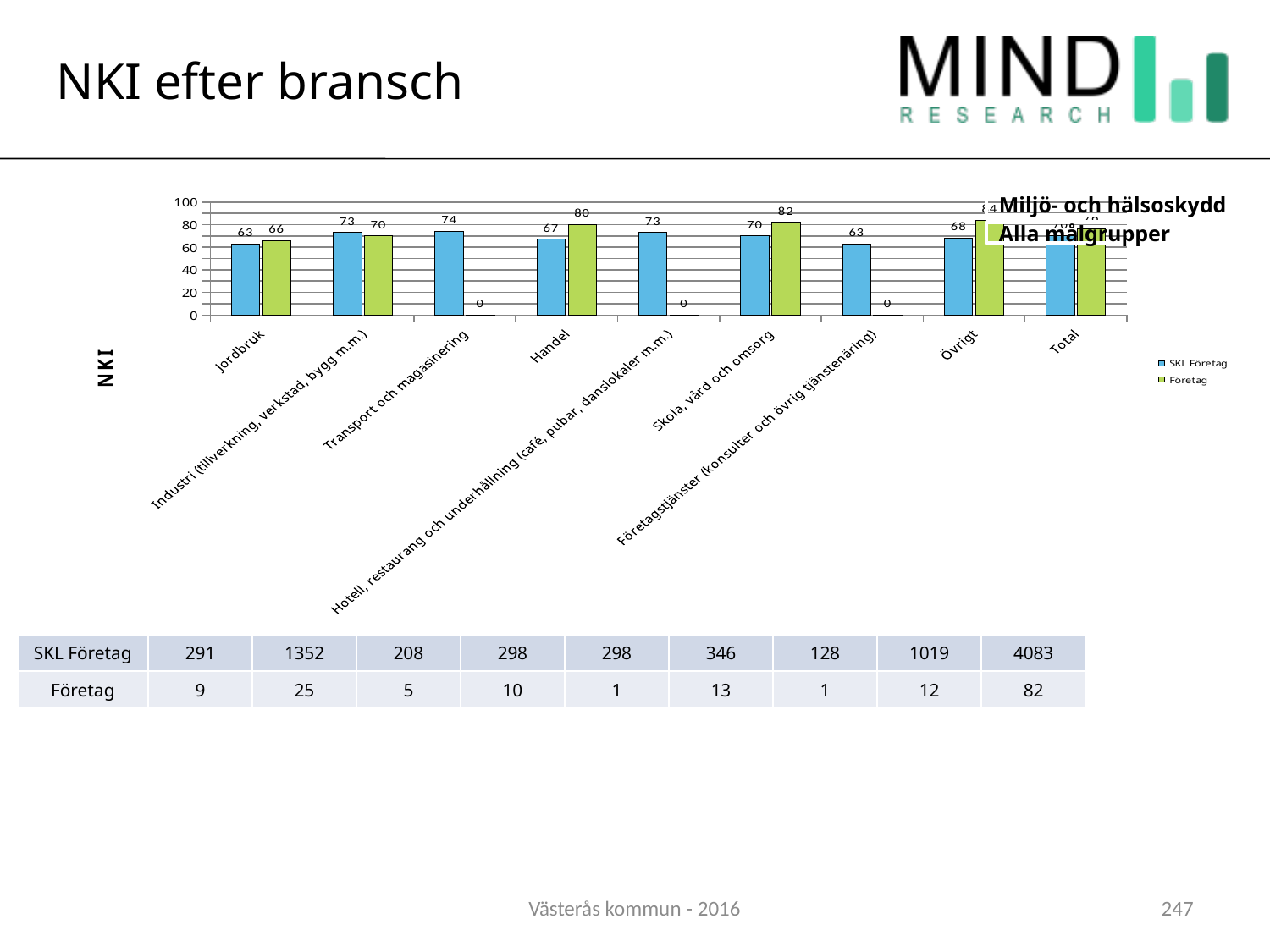
What is the SKL Företag value for Transport och magasinering? 74 What is the difference between the Företag and SKL Företag values for Handel? 13 Which series is shown in blue in the chart legend? SKL Företag Which is larger for Industri (tillverkning, verkstad, bygg m.m.): the SKL Företag value or the Företag value? SKL Företag What is the SKL Företag value for Jordbruk? 63 How many series does the chart legend list? 2 Which category has the highest SKL Företag value? Transport och magasinering What type of chart is shown on the slide? bar chart What is the Företag value for Skola, vård och omsorg? 82 What is the Företag value for Hotell, restaurang och underhållning (café, pubar, danslokaler m.m.)? 0 Is the SKL Företag value for Övrigt greater or less than 40? greater What is the Företag value for Handel? 80